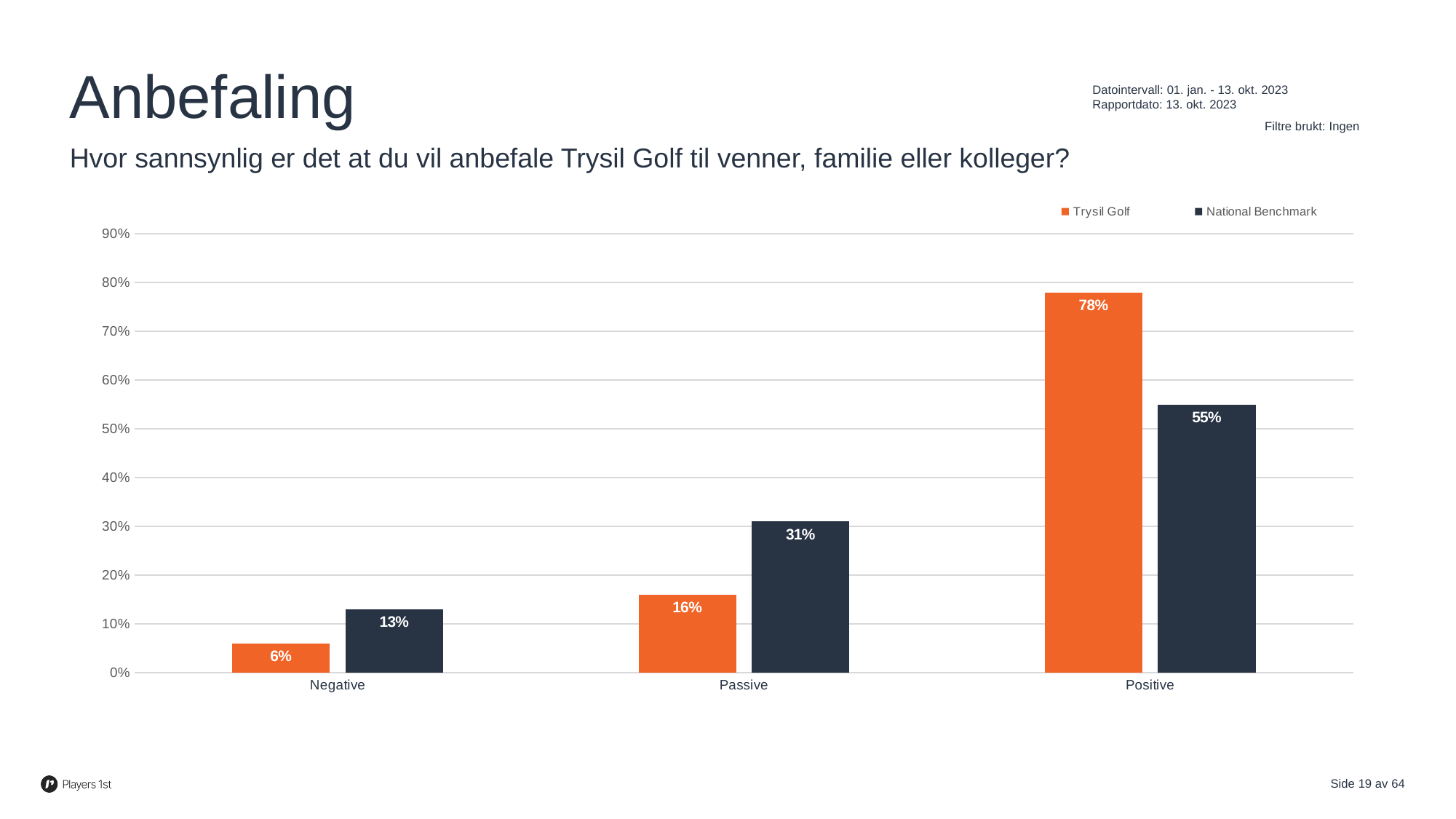
Which category has the lowest National Benchmark value? Negative What is the Trysil Golf value for Positive? 78% What is the National Benchmark value for Positive? 55% Which colour represents Trysil Golf in the chart? Orange For Passive, which is larger: Trysil Golf or National Benchmark? National Benchmark How many categories are shown on the x axis? 3 What kind of chart is shown on the slide? Bar chart How many series does the legend list? 2 What is the National Benchmark value for Passive? 31% What is the difference between the Trysil Golf and National Benchmark values for Positive? 23% Which category has the highest Trysil Golf value? Positive What is the Trysil Golf value for Negative? 6%